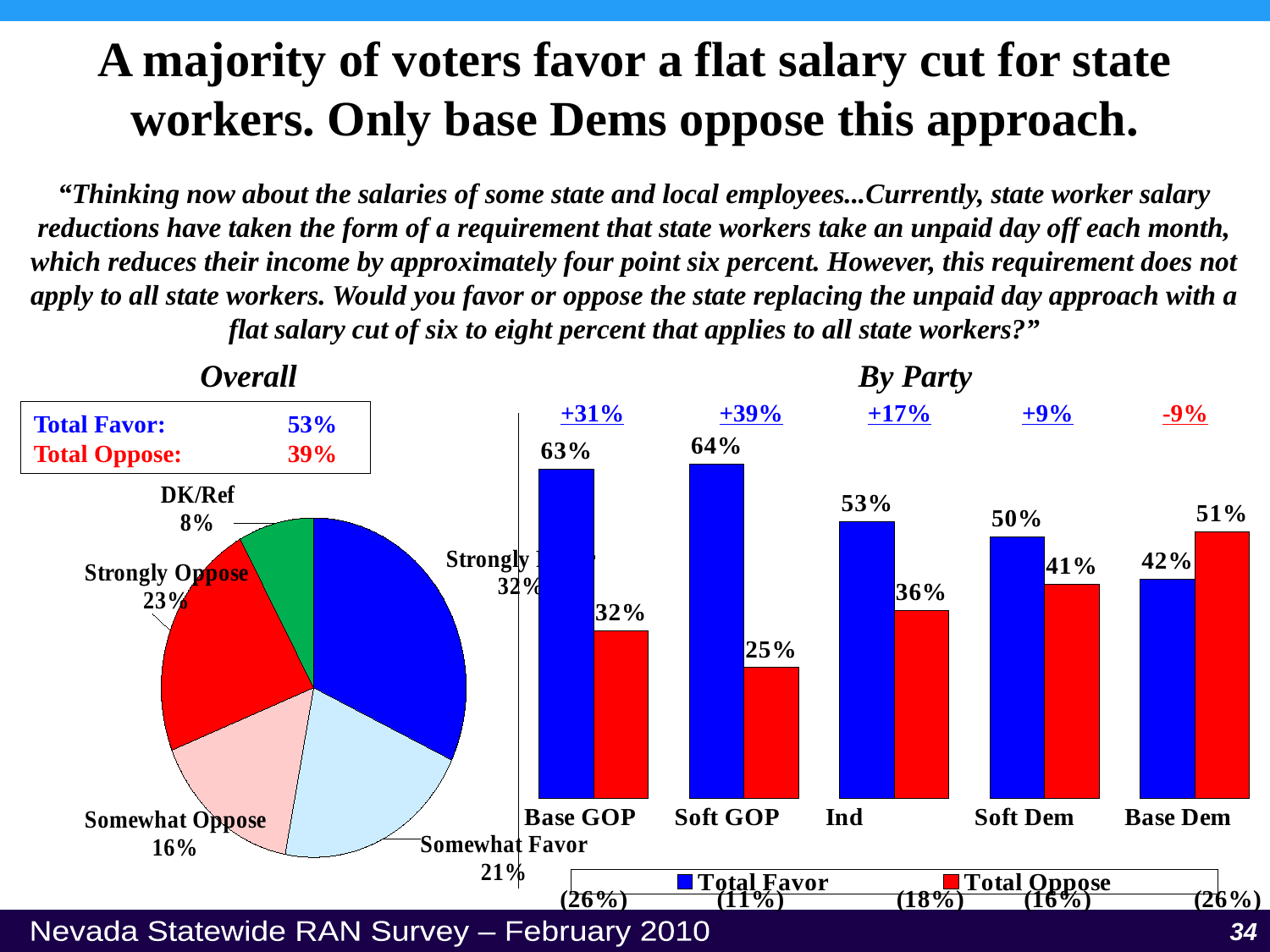
How many series does the legend of the By Party chart list? 2 In the By Party chart, is Total Favor or Total Oppose larger for Base Dem? Total Oppose In the By Party chart, what is the Total Favor value for Base GOP? 63% In the By Party chart, what is the difference between Total Favor and Total Oppose for Ind? 17% In the Overall pie chart, which slice is the smallest? DK/Ref In the By Party chart, which party group has the lowest Total Oppose value? Soft GOP What kind of chart is the By Party chart? bar chart In the By Party chart, what is the Total Oppose value for Soft Dem? 41% In the Overall pie chart, what share of voters answered DK/Ref? 8% How many party groups are shown on the x axis of the By Party chart? 5 In the By Party chart, which party group has the highest Total Favor value? Soft GOP In the Overall pie chart, what is the value for Somewhat Oppose? 16%